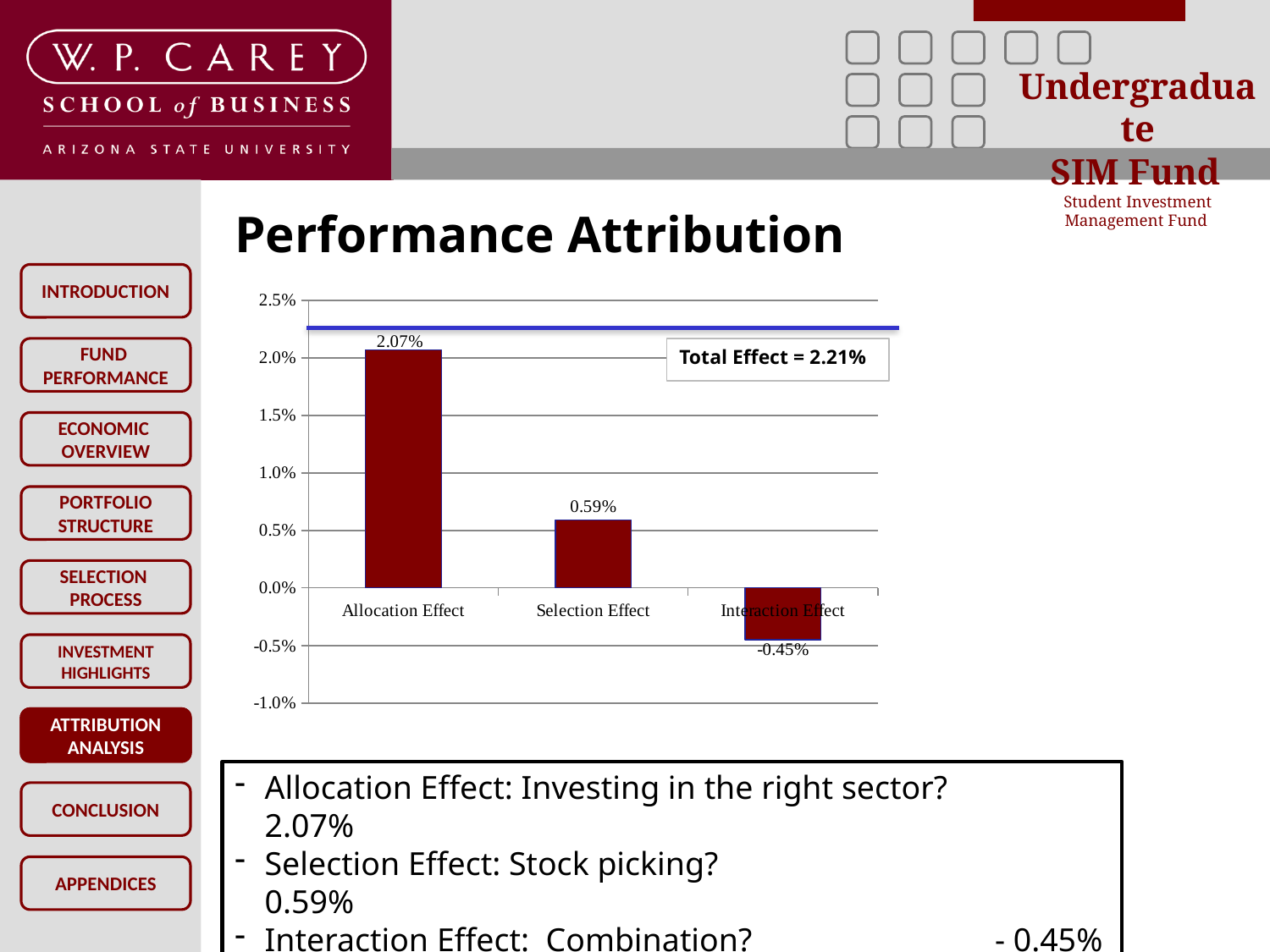
Do the values rise or fall from left to right across the categories? Fall Which is larger, the Selection Effect or the Interaction Effect? Selection Effect Is the value for Allocation Effect greater or less than 2.0%? greater What is the value for Selection Effect? 0.59% What is the difference between the Allocation Effect and the Selection Effect? 1.48% What kind of chart is shown on the slide? Bar chart How many categories are shown on the chart? 3 What total effect is stated in the text box on the chart? Total Effect = 2.21% What is the value for Interaction Effect? -0.45% Which category has the lowest value? Interaction Effect Which category has the highest value? Allocation Effect What is the value for Allocation Effect? 2.07%